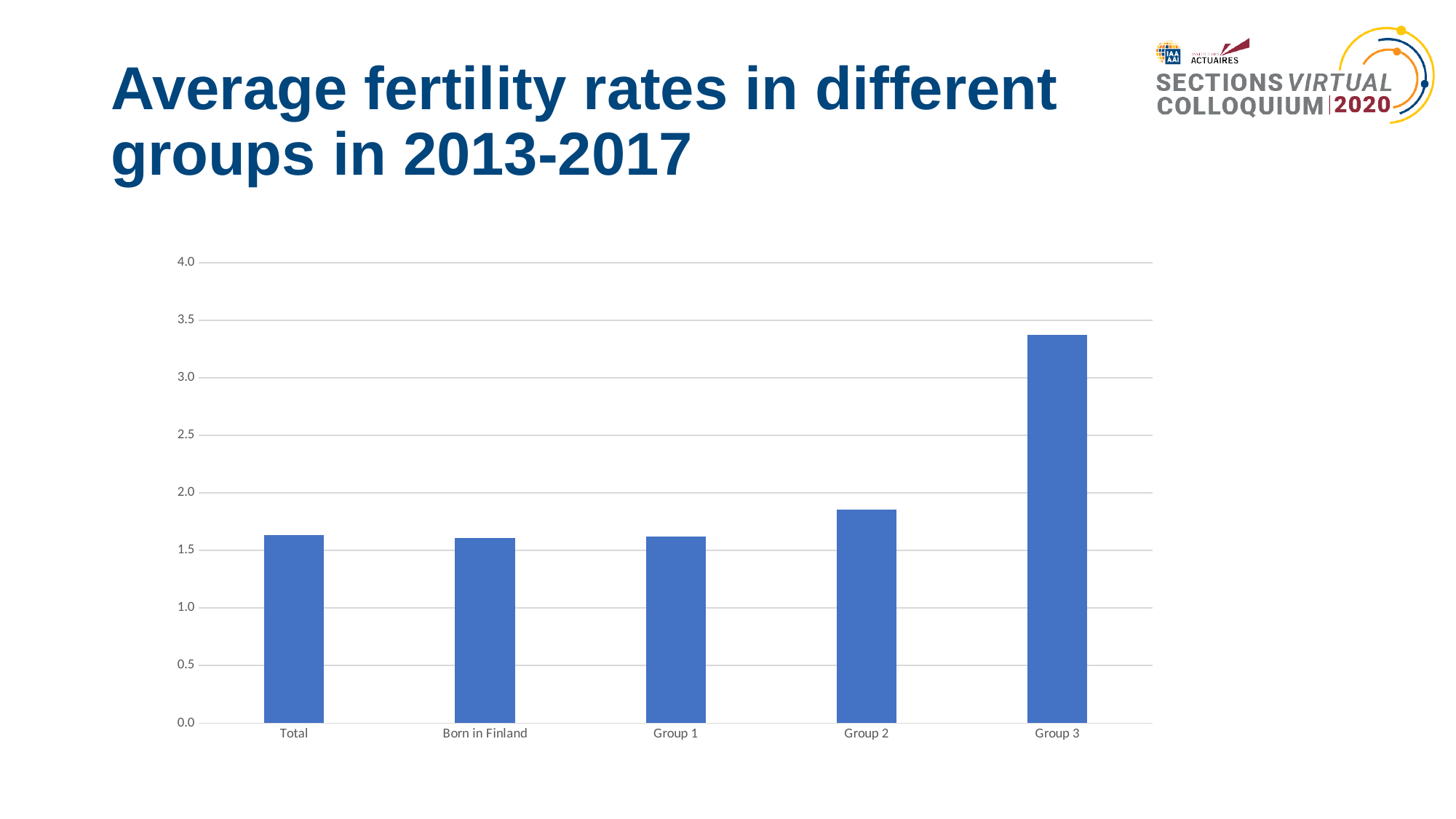
Is the value for Group 3 greater or less than 3.5? less Is the value for Group 2 greater or less than 2.0? less Is the value for Group 2 greater or less than 1.5? greater How many categories are plotted on the x axis? 5 Which category has the highest average fertility rate? Group 3 Which is larger, the value for Group 2 or the value for Group 1? Group 2 What kind of chart is shown on the slide? bar chart Which is larger, the value for Group 3 or the value for Total? Group 3 What is the title of the slide containing the chart? Average fertility rates in different groups in 2013-2017